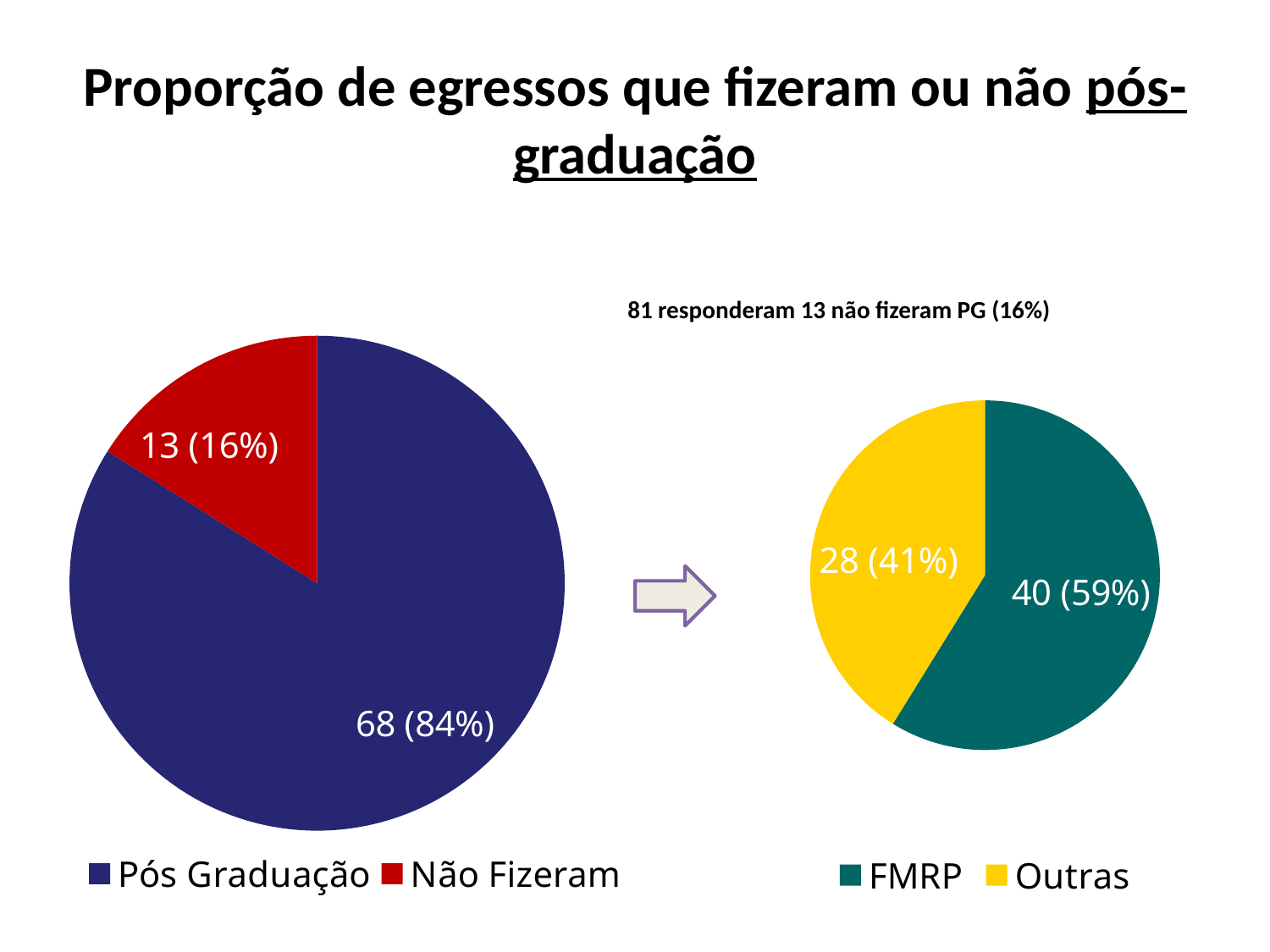
In the right pie chart, which is larger, FMRP or Outras? FMRP How many categories does the legend of the right pie chart list? 2 In the left pie chart, what is the value shown for Pós Graduação? 68 (84%) In the left pie chart, what is the value shown for Não Fizeram? 13 (16%) In the left pie chart, what is the difference in count between Pós Graduação and Não Fizeram? 55 In the left pie chart, which category has the largest slice? Pós Graduação In the left pie chart, what share of the pie does Não Fizeram represent? 16% In the right pie chart, what is the value shown for FMRP? 40 (59%) What type of chart is used on the left of the slide? Pie chart In the right pie chart, which category has the smallest slice? Outras In the right pie chart, what is the value shown for Outras? 28 (41%) In the right pie chart, what is the difference in count between FMRP and Outras? 12